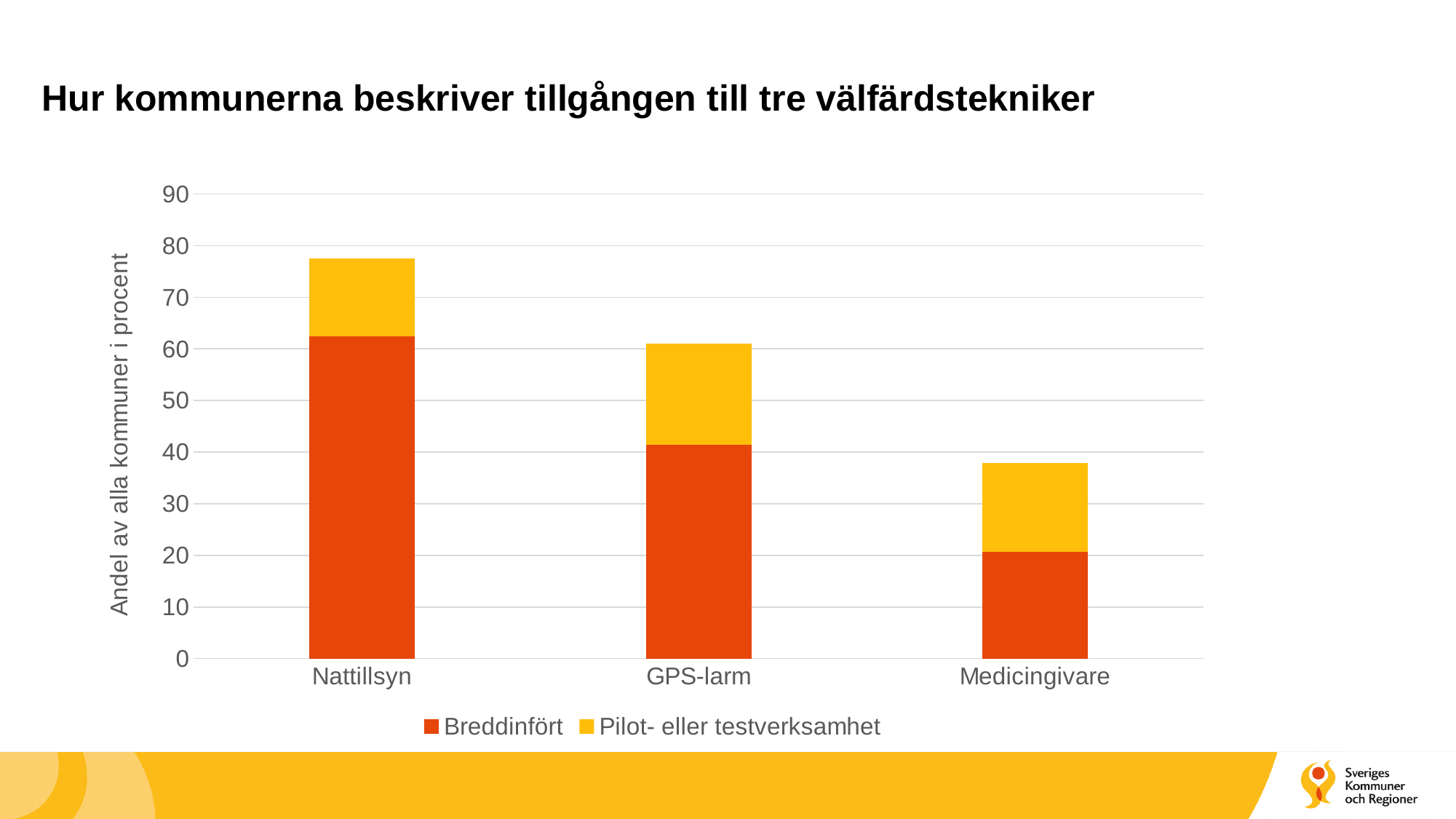
Is the total stacked bar for GPS-larm greater or less than 70? less How many series does the legend list? 2 Which category has the shortest stacked bar overall? Medicingivare Which category has the largest Breddinfört segment? Nattillsyn Which category has the tallest stacked bar overall? Nattillsyn Is the Breddinfört value for Nattillsyn greater or less than 60? greater How many categories are shown on the x axis? 3 Which is larger, the Breddinfört value for GPS-larm or the Breddinfört value for Medicingivare? GPS-larm What kind of chart is shown on the slide? Stacked bar chart Is the total stacked bar for Medicingivare greater or less than 30? greater Do the total bar heights rise or fall from Nattillsyn to Medicingivare along the x axis? Fall Which category has the smallest Breddinfört segment? Medicingivare